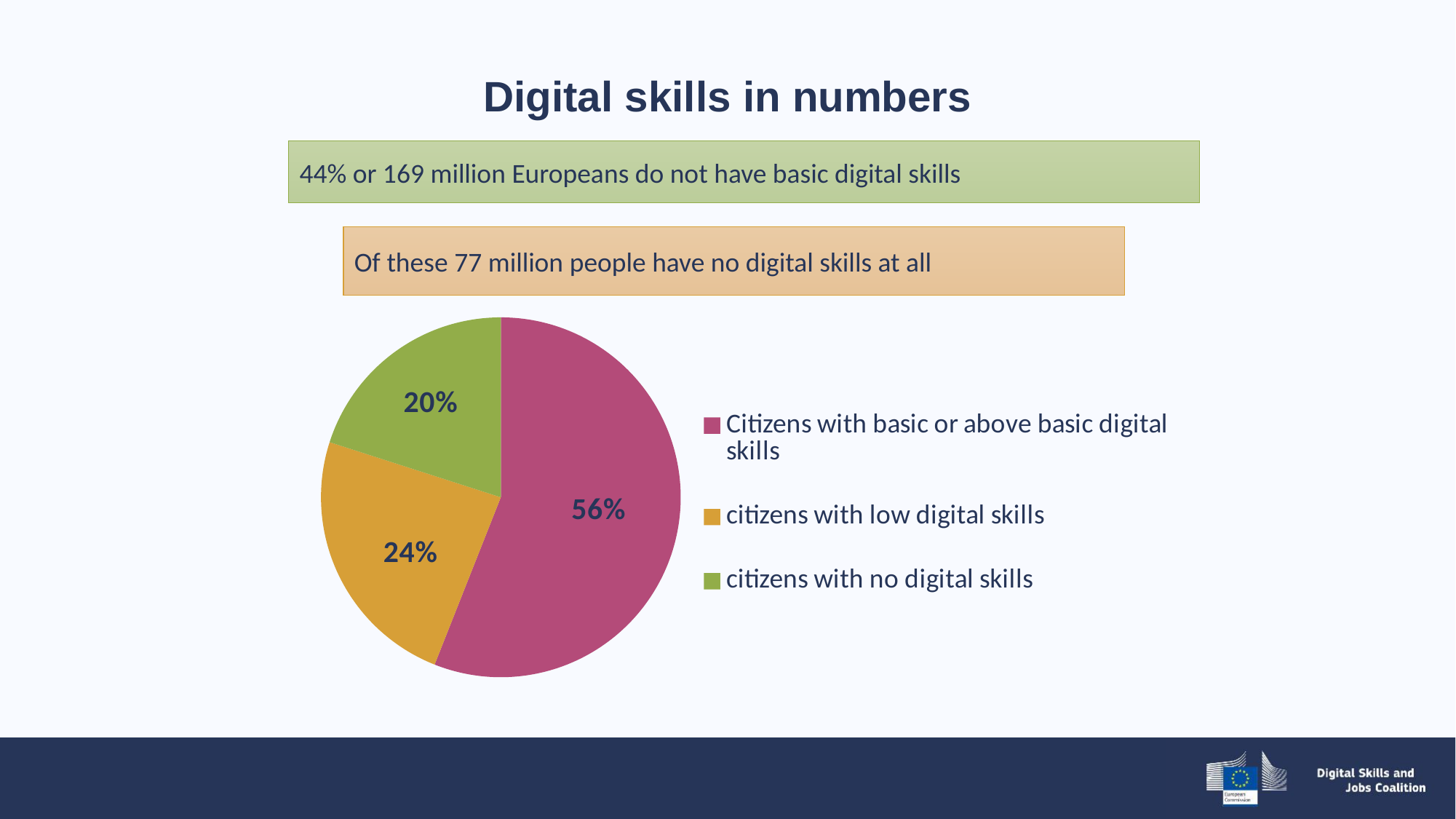
How many entries does the legend list? 3 What kind of chart is shown on the slide? pie chart What is the difference in percentage points between the slice for citizens with low digital skills and the slice for citizens with no digital skills? 4 What colour is the slice for citizens with no digital skills? green How many slices does the pie chart have? 3 Which category has the largest slice of the pie? Citizens with basic or above basic digital skills What share of the pie is labelled for citizens with basic or above basic digital skills? 56% What share of the pie is labelled for citizens with no digital skills? 20% What is the difference in percentage points between the slice for citizens with basic or above basic digital skills and the slice for citizens with low digital skills? 32 Which category has the smallest slice of the pie? citizens with no digital skills What share of the pie is labelled for citizens with low digital skills? 24% Which slice is larger: citizens with low digital skills or citizens with no digital skills? citizens with low digital skills